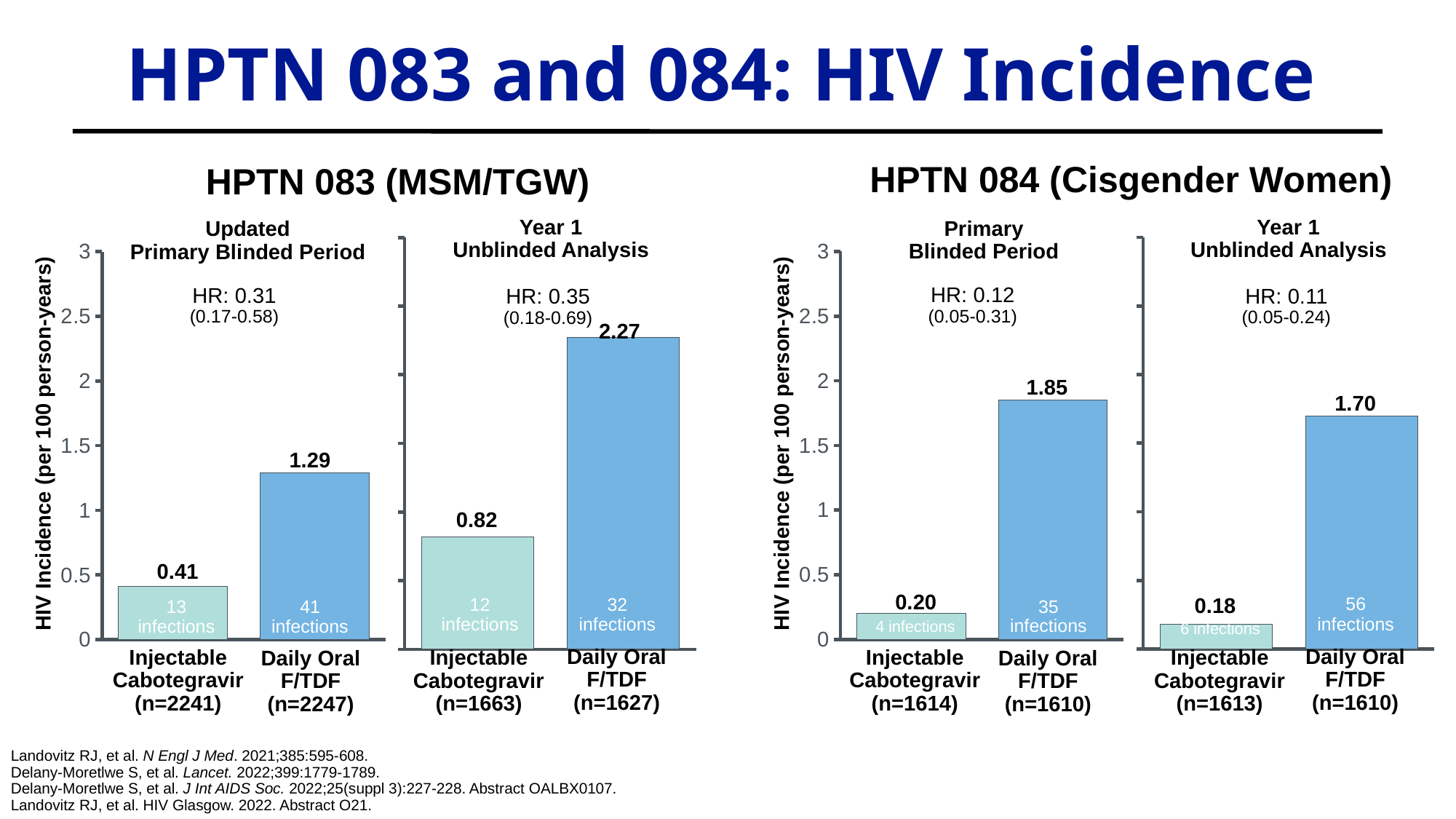
In the HPTN 084 Primary Blinded Period chart, which arm has the higher HIV incidence? Daily Oral F/TDF What kind of chart is used in the HPTN 084 Year 1 Unblinded Analysis panel? Bar chart In the HPTN 083 Updated Primary Blinded Period chart, what is the difference in HIV incidence between Daily Oral F/TDF and Injectable Cabotegravir? 0.88 In the HPTN 084 Primary Blinded Period chart, what is the HIV incidence for Injectable Cabotegravir? 0.20 In the HPTN 083 Updated Primary Blinded Period chart, what is the HIV incidence for Daily Oral F/TDF? 1.29 In the HPTN 084 Year 1 Unblinded Analysis chart, how many infections are shown for Daily Oral F/TDF? 56 infections In the HPTN 083 Year 1 Unblinded Analysis chart, what is the HIV incidence for Daily Oral F/TDF? 2.27 In the HPTN 083 Year 1 Unblinded Analysis chart, how many infections are shown for Injectable Cabotegravir? 12 infections What hazard ratio is shown in the HPTN 084 Primary Blinded Period chart? HR: 0.12 (0.05-0.31) In the HPTN 083 Year 1 Unblinded Analysis chart, is the value for Daily Oral F/TDF greater or less than 2? greater In the HPTN 084 Year 1 Unblinded Analysis chart, what is the HIV incidence for Daily Oral F/TDF? 1.70 In the HPTN 083 Updated Primary Blinded Period chart, what is the HIV incidence for Injectable Cabotegravir? 0.41